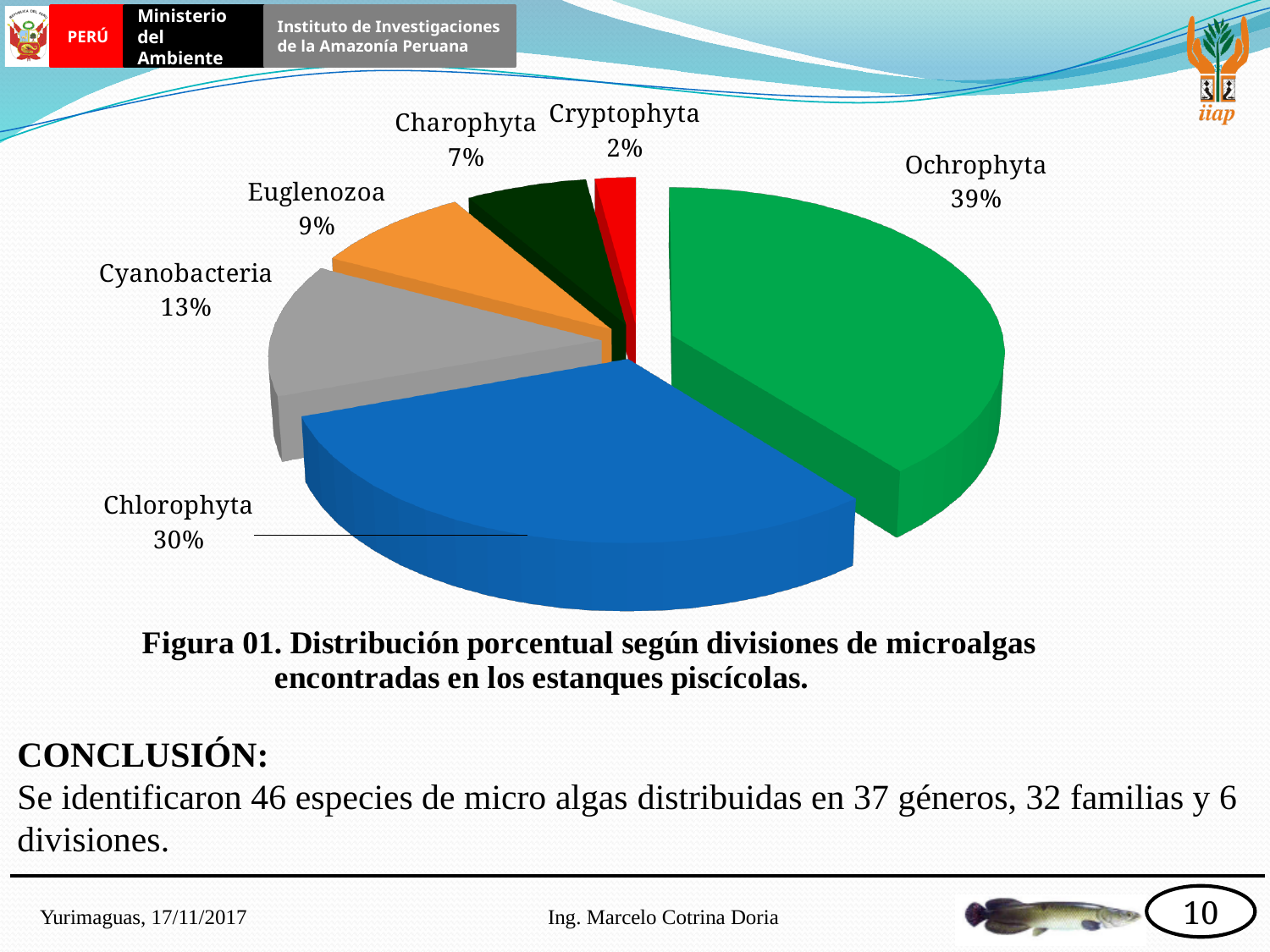
What percentage of the pie does Chlorophyta represent? 30% What percentage of the pie does Ochrophyta represent? 39% How many divisions (slices) are shown in the pie chart? 6 What percentage of the pie does Cyanobacteria represent? 13% What type of chart is shown on the slide? Pie chart What is the difference in percentage points between Ochrophyta and Chlorophyta? 9 What percentage of the pie does Euglenozoa represent? 9% What percentage of the pie does Cryptophyta represent? 2% Which division has the smallest share of the pie? Cryptophyta What colour is the Chlorophyta slice? Blue Which division has the largest share of the pie? Ochrophyta Which has a larger share, Euglenozoa or Charophyta? Euglenozoa